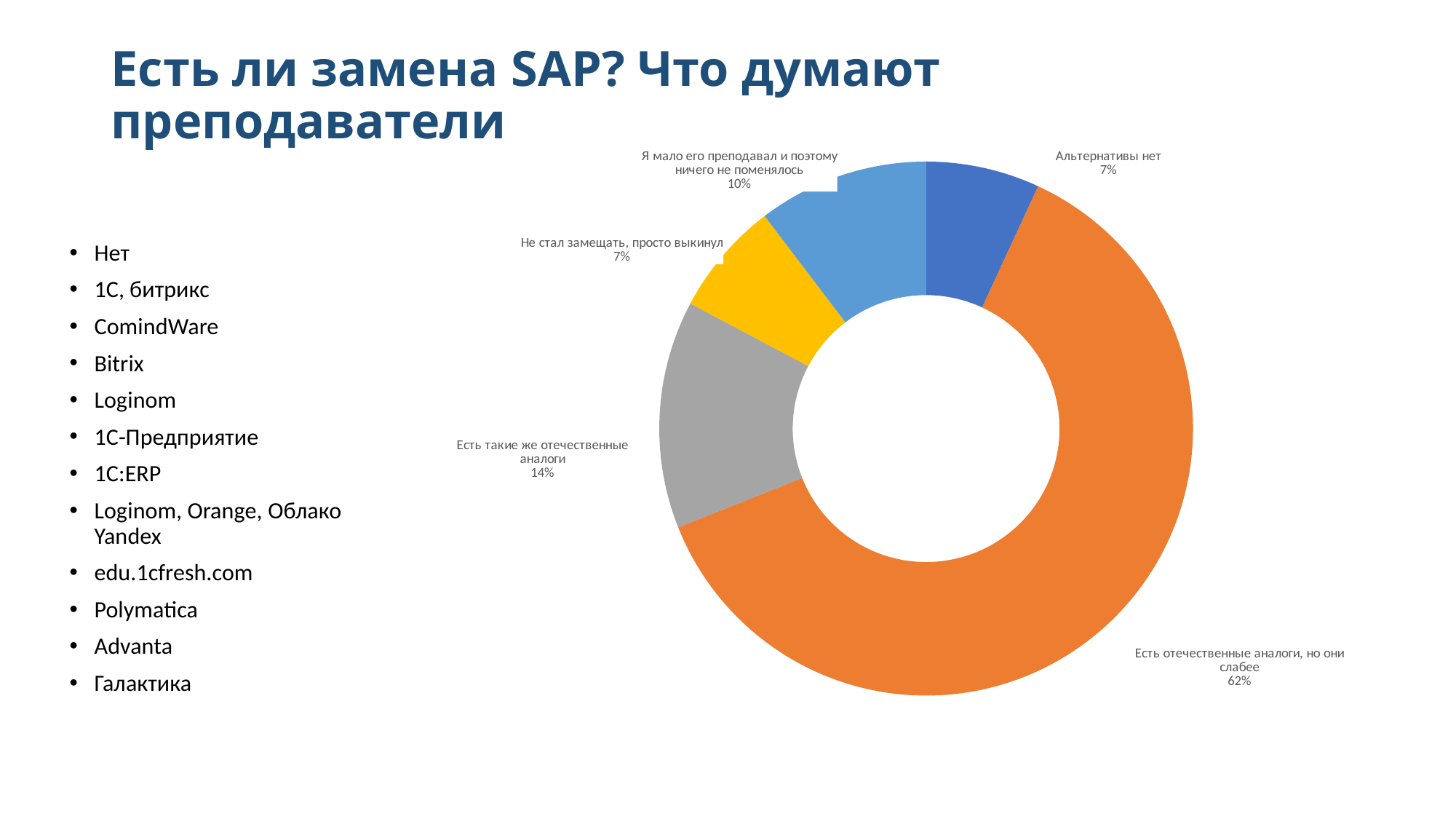
What percentage is shown for "Альтернативы нет"? 7% What percentage is shown for "Есть такие же отечественные аналоги"? 14% What percentage is shown for "Я мало его преподавал и поэтому ничего не поменялось"? 10% What colour is the slice for "Есть отечественные аналоги, но они слабее"? Orange What is the difference in percentage points between "Есть отечественные аналоги, но они слабее" and "Есть такие же отечественные аналоги"? 48 percentage points Which answer has the largest share of the chart? Есть отечественные аналоги, но они слабее What percentage is shown for "Не стал замещать, просто выкинул"? 7% What kind of chart is shown on the slide? Doughnut (pie) chart What share of respondents answered "Есть отечественные аналоги, но они слабее"? 62% Which is larger: the share for "Я мало его преподавал и поэтому ничего не поменялось" or for "Альтернативы нет"? Я мало его преподавал и поэтому ничего не поменялось How many slices does the chart have? 5 What is the combined share of "Альтернативы нет" and "Не стал замещать, просто выкинул"? 14%